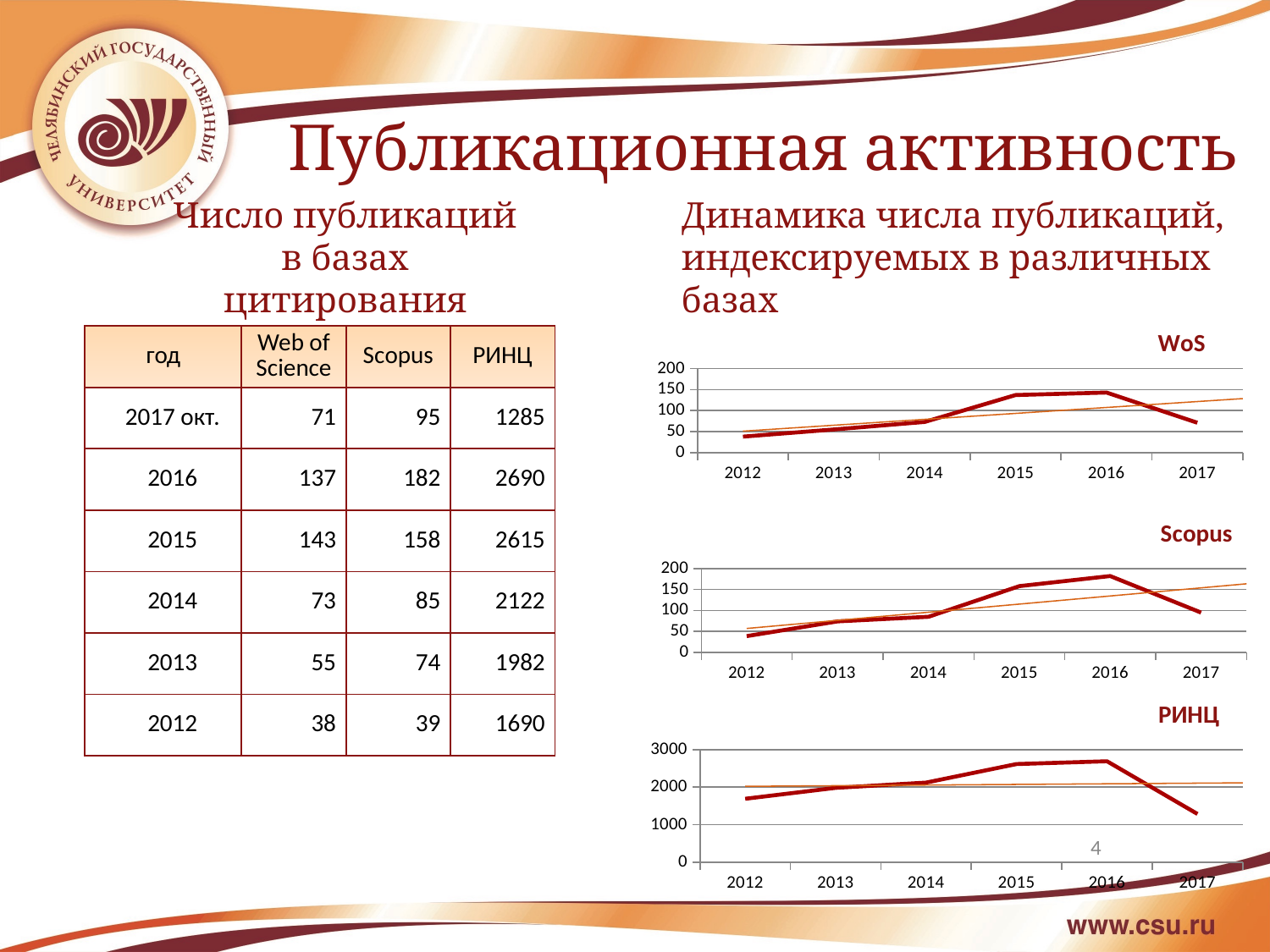
In the Scopus chart, is the value for 2015 larger than the value for 2014? yes How many years are plotted along the x axis of the Scopus chart? 6 In the РИНЦ chart, which year has the lowest value? 2017 In the WoS chart, is the value for 2015 greater or less than 100? greater In the РИНЦ chart, do the values rise or fall from 2016 to 2017? fall In the РИНЦ chart, is the value for 2012 greater or less than 2000? less In the Scopus chart, is the value for 2016 greater or less than 150? greater What is the title of the bottom chart on the right side of the slide? РИНЦ In the WoS chart, which year has the lowest value? 2012 In the Scopus chart, which year has the highest value? 2016 What kind of chart is the WoS chart on the right side of the slide? line chart How many charts are shown on the right side of the slide? 3